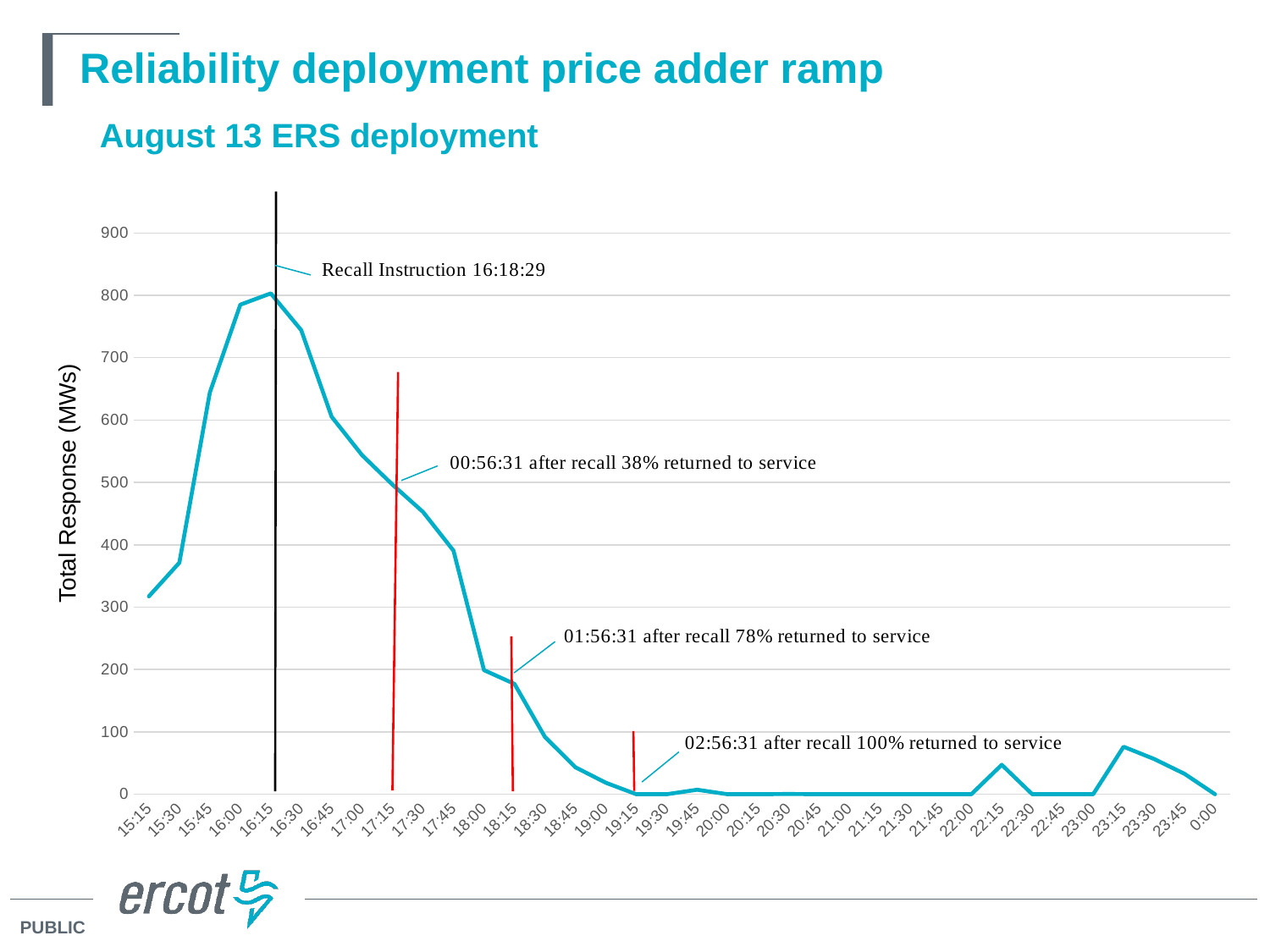
Is the Total Response at 16:00 greater or less than 700 MWs? greater Is the Total Response at 23:15 greater or less than 100 MWs? less Is the Total Response at 15:45 greater or less than 600 MWs? greater At which time does the Total Response reach its highest value? 16:15 Which time has a larger Total Response, 16:00 or 17:00? 16:00 What time is given for the Recall Instruction in the chart annotation? 16:18:29 According to the chart annotation, what percentage had returned to service 01:56:31 after recall? 78% What kind of chart is shown on the slide? line chart Which time has a larger Total Response, 22:15 or 23:15? 23:15 Does the Total Response rise or fall between 16:15 and 19:15? fall